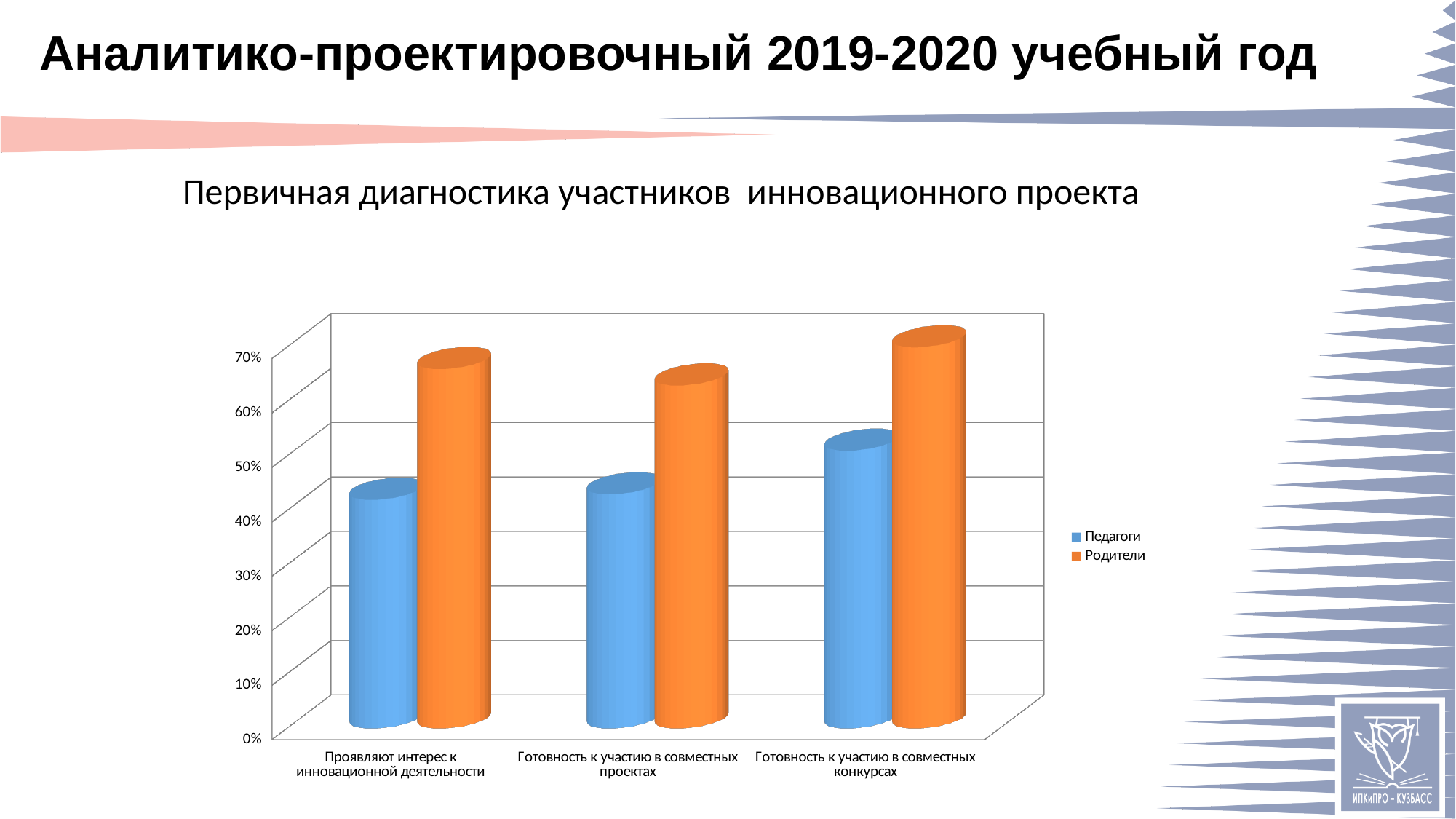
For the category 'Готовность к участию в совместных конкурсах', which series has the larger value, Педагоги or Родители? Родители In which category is the value for Педагоги the highest? Готовность к участию в совместных конкурсах In which category is the value for Родители the highest? Готовность к участию в совместных конкурсах Is the value for Педагоги in 'Готовность к участию в совместных проектах' greater or less than 50%? less Is the value for Родители in 'Готовность к участию в совместных проектах' greater or less than 60%? greater What kind of chart is shown on the slide? bar chart How many categories are shown on the x axis? 3 How many series does the legend list? 2 What is the title above the chart? Первичная диагностика участников инновационного проекта Which series is shown in orange? Родители Is the value for Педагоги in 'Проявляют интерес к инновационной деятельности' greater or less than 40%? greater For the category 'Проявляют интерес к инновационной деятельности', which series has the larger value, Педагоги or Родители? Родители